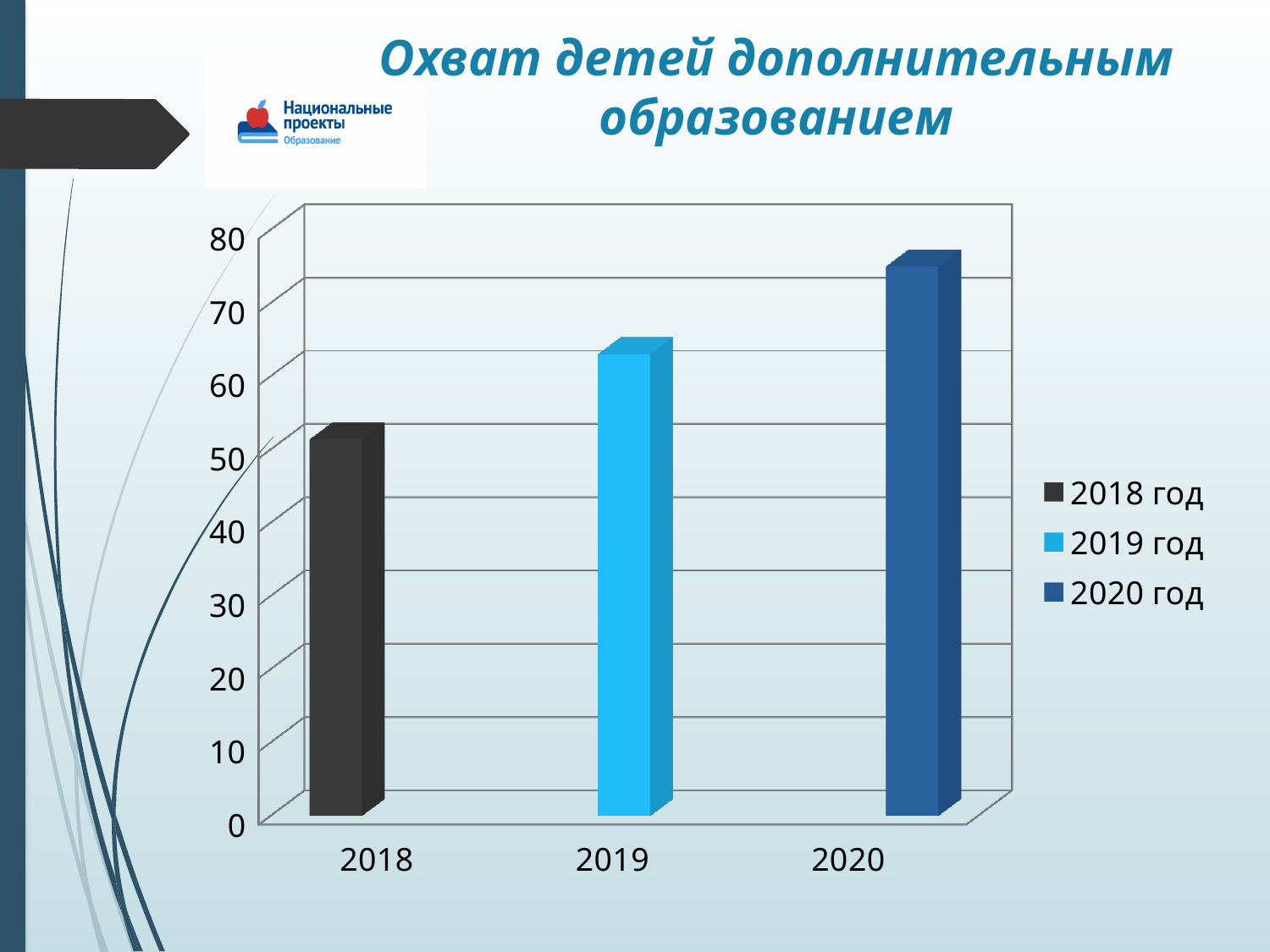
Do the values rise or fall from 2018 to 2020? rise How many bars (categories) are plotted in the chart? 3 Which is larger, the value for 2019 or the value for 2018? 2019 How many entries does the chart's legend list? 3 Is the value for 2018 greater or less than 60? less What kind of chart is shown on the slide? bar chart Which year has the highest bar in the chart? 2020 Which year has the lowest bar in the chart? 2018 What is the title of the chart on the slide? Охват детей дополнительным образованием Is the value for 2020 greater or less than 70? greater Which legend entry is shown in light blue? 2019 год Is the value for 2019 greater or less than 60? greater